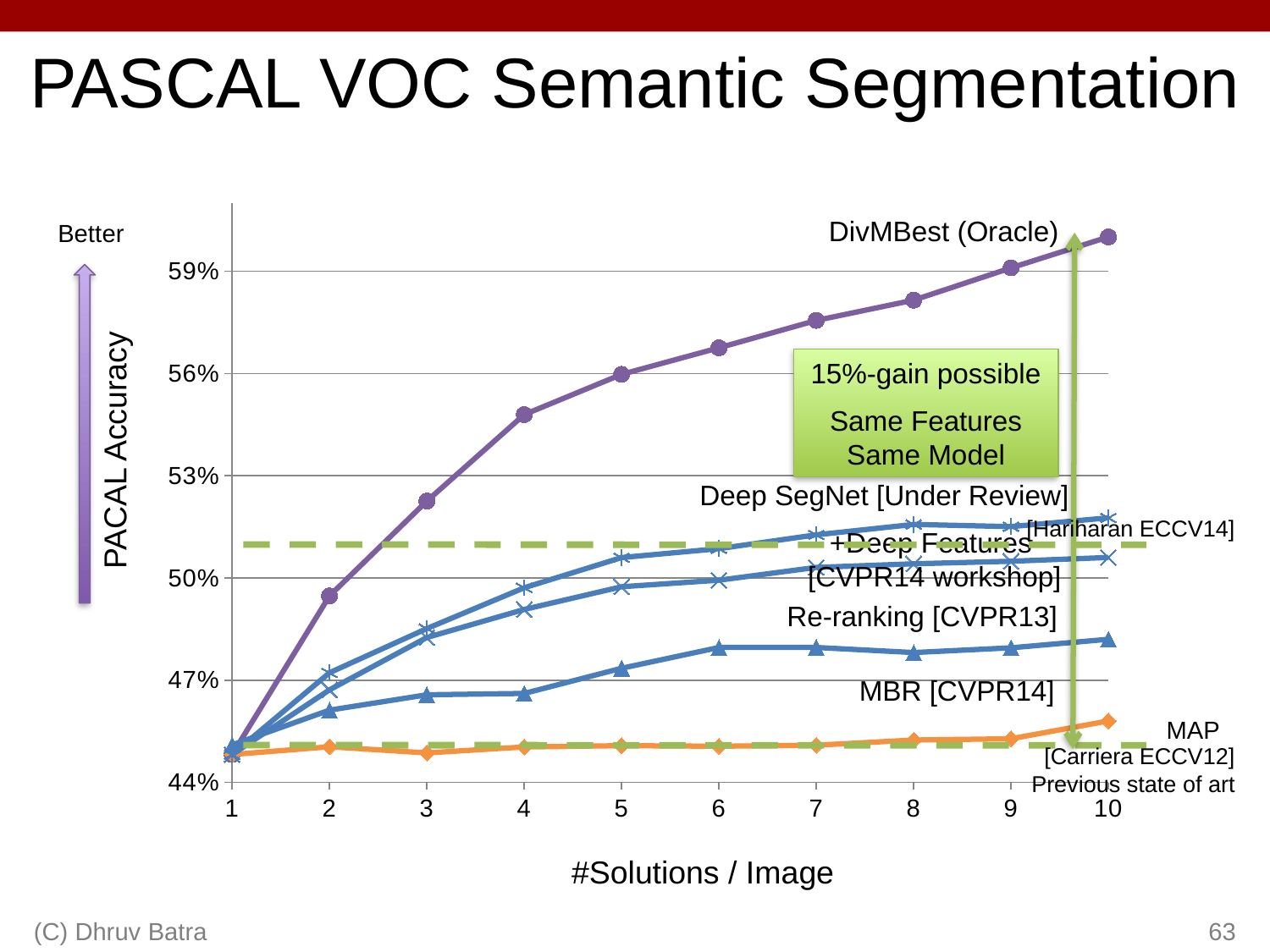
What is the title of the y axis? PACAL Accuracy How many values of #Solutions / Image are shown along the x axis? 10 Is the value for MAP at 10 solutions per image greater or less than 47%? less Does the DivMBest (Oracle) line rise or fall as #Solutions / Image increases? rises Which line has the lowest PACAL Accuracy at 10 solutions per image? MAP What is the title of the x axis? #Solutions / Image At 10 solutions per image, which is larger: DivMBest (Oracle) or MAP? DivMBest (Oracle) What kind of chart is shown on the slide? line chart Is the value for DivMBest (Oracle) at 10 solutions per image greater or less than 59%? greater Is the value for DivMBest (Oracle) at 4 solutions per image greater or less than 53%? greater Which line has the highest PACAL Accuracy at 10 solutions per image? DivMBest (Oracle)